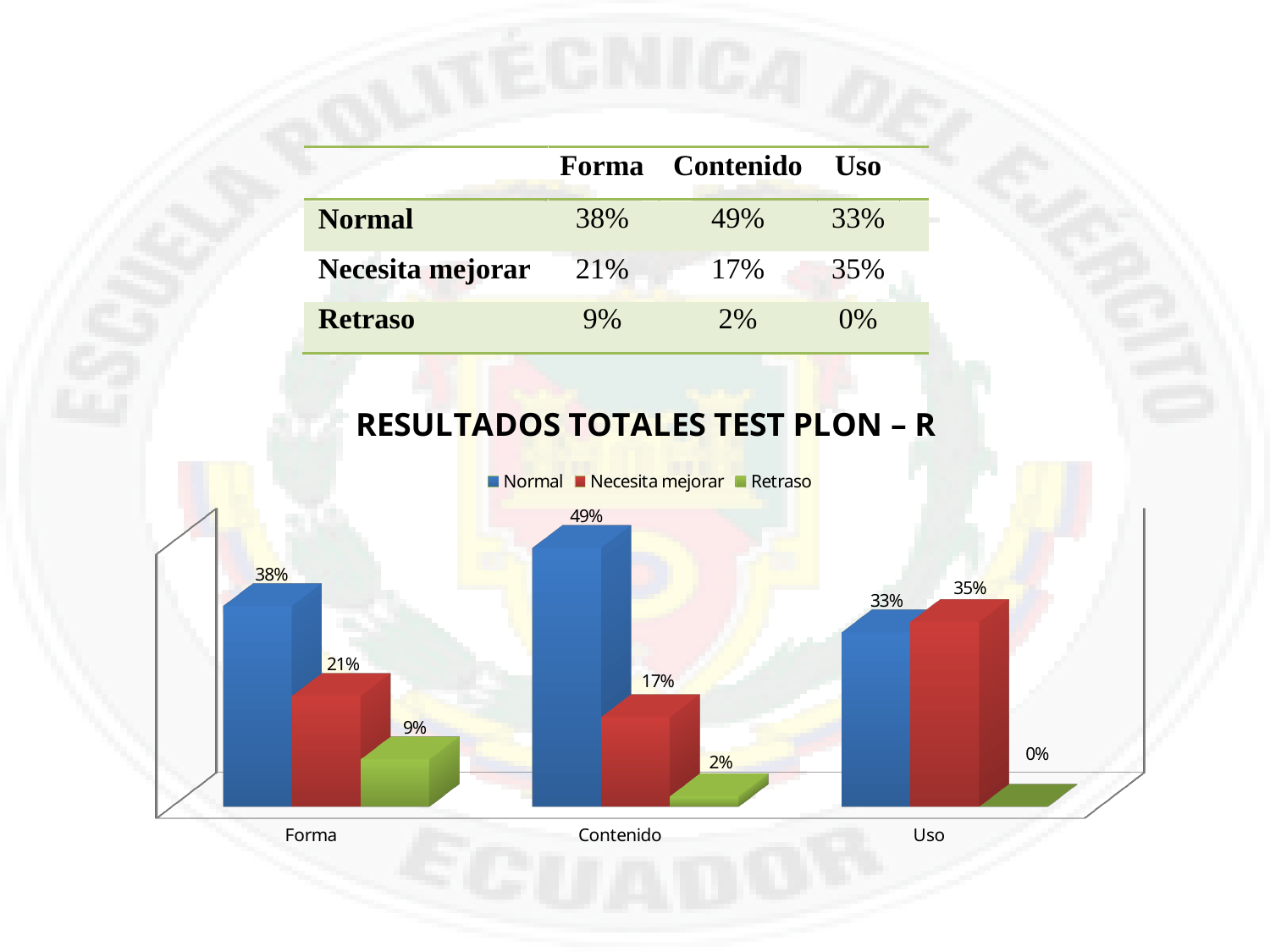
What is the value for Normal in the Contenido category? 49% Which category has the lowest value for the Retraso series? Uso In the Uso category, which is larger: Normal or Necesita mejorar? Necesita mejorar What is the value for Necesita mejorar in the Uso category? 35% Which colour represents the Retraso series in the chart? Green How many categories are shown on the x axis? 3 What is the value for Retraso in the Forma category? 9% How many series does the legend list? 3 What is the title of the chart? RESULTADOS TOTALES TEST PLON – R What kind of chart is shown on the slide? Bar chart What is the difference between the Normal and Necesita mejorar values in the Forma category? 17% Which category has the highest value for the Normal series? Contenido